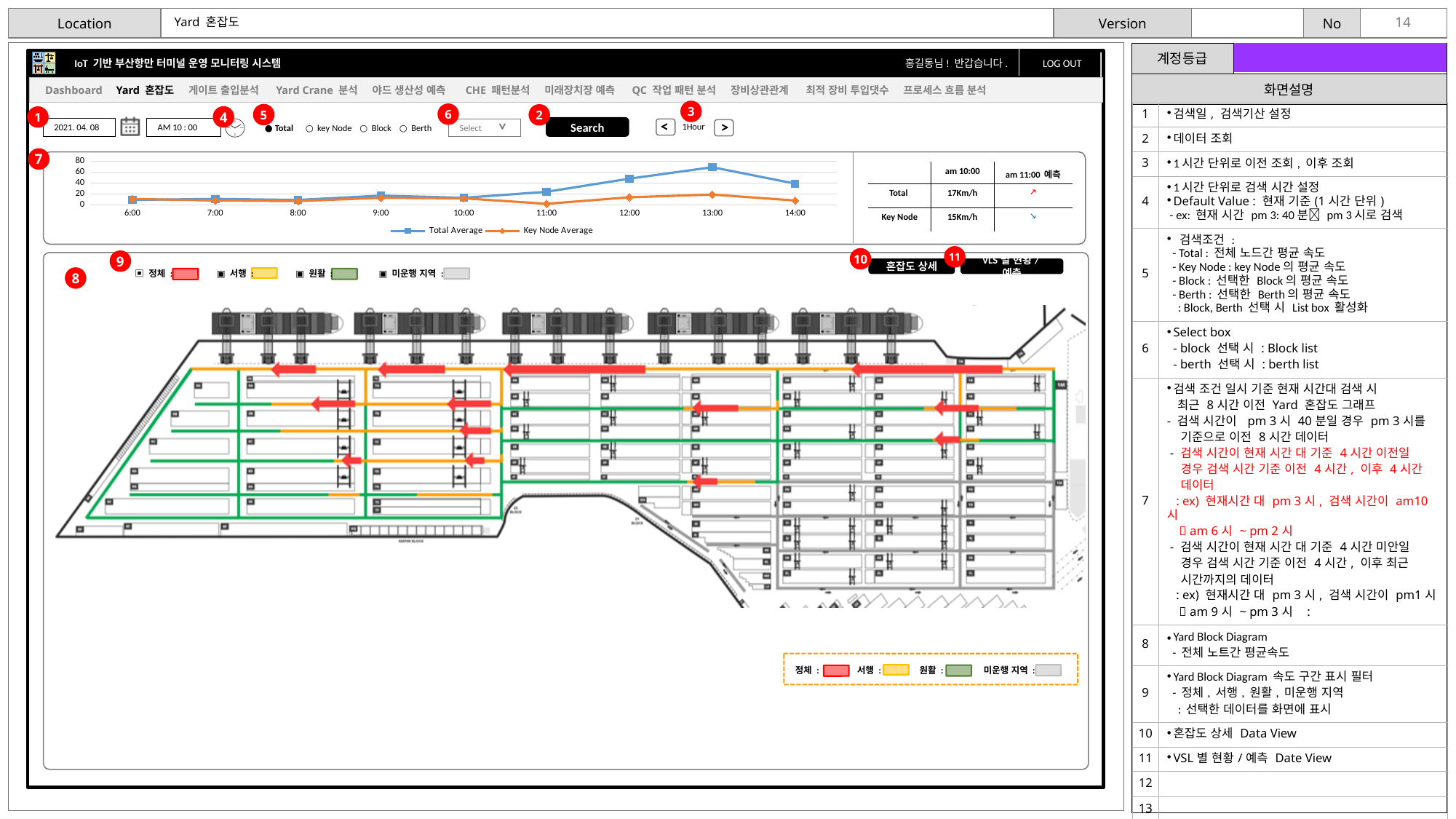
How many time points are plotted along the x axis of the line chart? 9 Is the Total Average value at 13:00 greater or less than 60? greater Is the Key Node Average value at 13:00 greater or less than 40? less What are the two series named in the line chart's legend? Total Average and Key Node Average Is the Total Average value at 6:00 greater or less than 20? less At 13:00, which series has the larger value, Total Average or Key Node Average? Total Average At which time does the Total Average series reach its highest value? 13:00 Which colour is used for the Key Node Average series in the line chart? orange Does the Total Average series rise or fall between 13:00 and 14:00? fall What kind of chart is shown at the top of the screen mockup? line chart How many series does the legend of the line chart list? 2 Does the Total Average series rise or fall between 11:00 and 13:00? rise